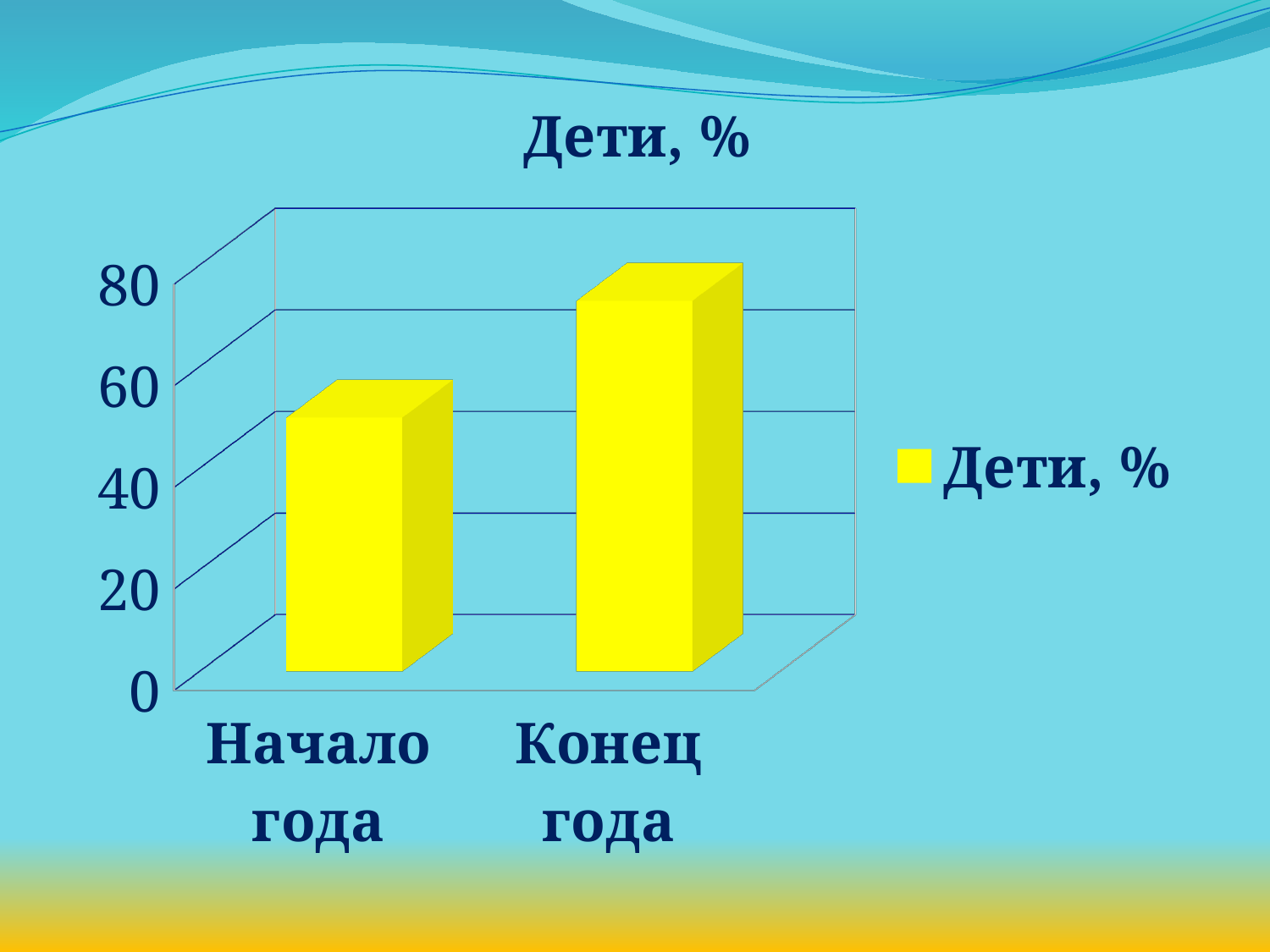
Is the value for Начало года greater or less than 40? greater How many categories are shown on the x axis of the chart? 2 What is the title of the chart? Дети, % Is the value for Конец года greater or less than 80? less Which category has the highest value? Конец года Is the value for Начало года greater or less than 60? less Do the values rise or fall from Начало года to Конец года? rise Which is larger, the value for Начало года or the value for Конец года? Конец года What kind of chart is shown on the slide? bar chart Which category has the lowest value? Начало года How many series does the legend list? 1